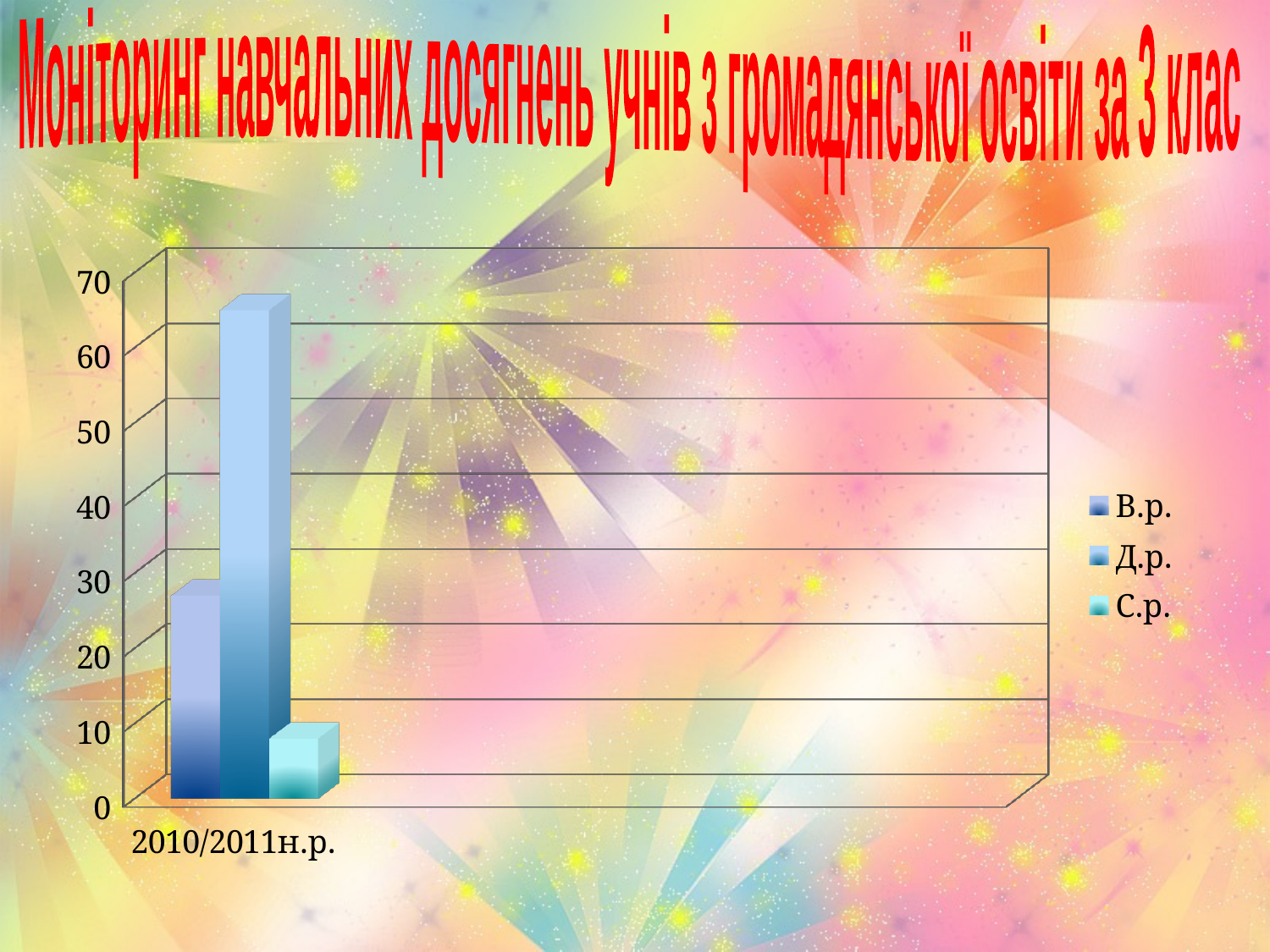
Which series has the highest value for 2010/2011н.р.? Д.р. Which is larger for 2010/2011н.р., В.р. or С.р.? В.р. What is the category label shown on the x axis? 2010/2011н.р. Is the value for В.р. greater or less than 30? less How many series does the legend list? 3 Which is larger for 2010/2011н.р., Д.р. or В.р.? Д.р. How many categories are shown on the x axis? 1 Which series has the lowest value for 2010/2011н.р.? С.р. Is the value for Д.р. greater or less than 60? greater What kind of chart is shown on the slide? bar chart What is the highest value shown on the vertical axis? 70